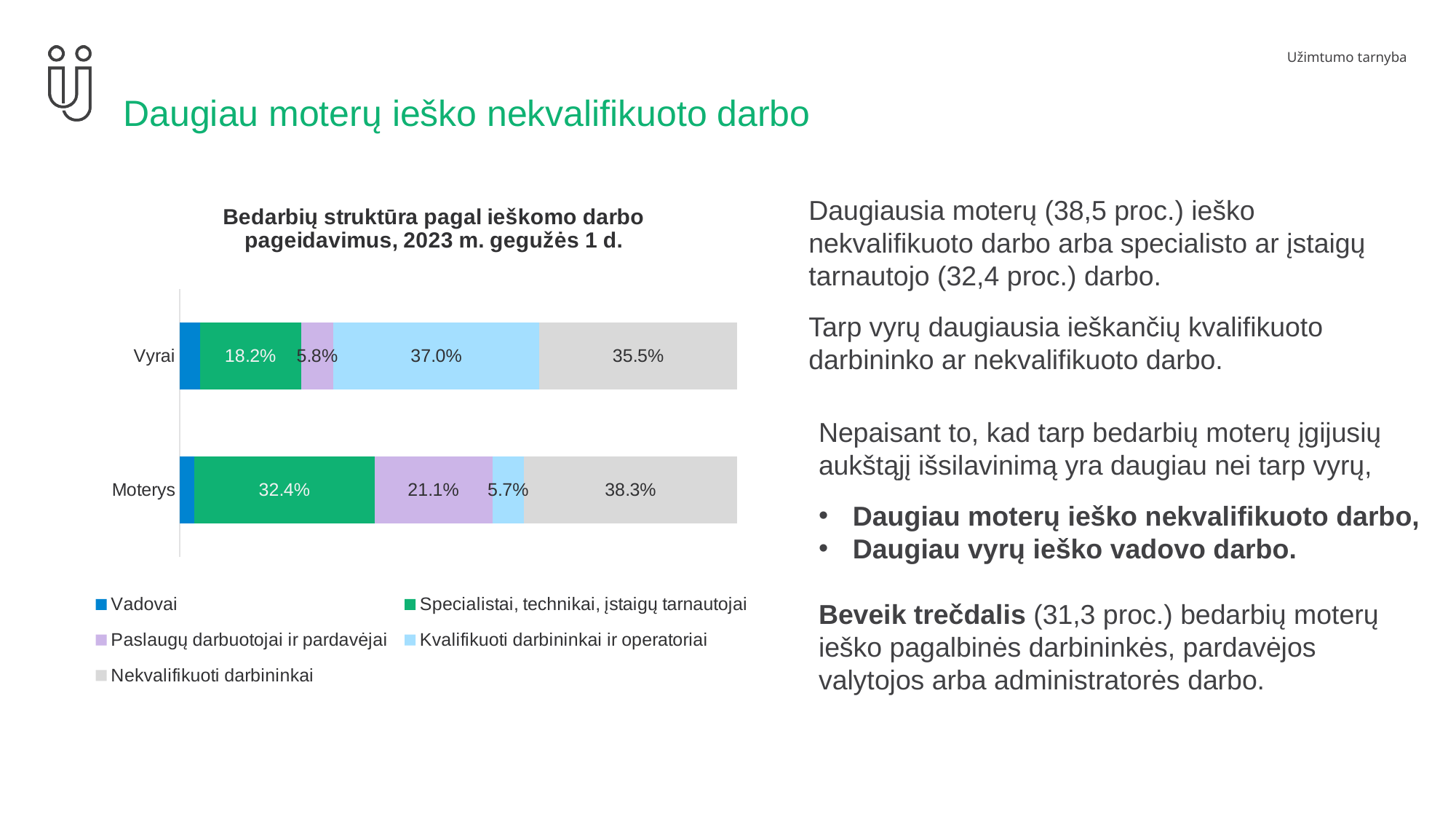
Which labelled segment is the largest in the Vyrai bar? Kvalifikuoti darbininkai ir operatoriai (37.0%) What is the value for Paslaugų darbuotojai ir pardavėjai in the Vyrai bar? 5.8% What is the difference between the Paslaugų darbuotojai ir pardavėjai share for Moterys and for Vyrai? 15.3% What kind of chart is shown on the slide? Stacked bar chart Which is larger: the Kvalifikuoti darbininkai ir operatoriai share for Vyrai or for Moterys? Vyrai What is the value for Specialistai, technikai, įstaigų tarnautojai in the Moterys bar? 32.4% How many categories (bars) are shown in the chart? 2 What is the difference between the Specialistai, technikai, įstaigų tarnautojai share for Moterys and for Vyrai? 14.2% What is the value for Kvalifikuoti darbininkai ir operatoriai in the Vyrai bar? 37.0% How many series does the legend list? 5 What is the value for Nekvalifikuoti darbininkai in the Moterys bar? 38.3% What is the title of the chart? Bedarbių struktūra pagal ieškomo darbo pageidavimus, 2023 m. gegužės 1 d.